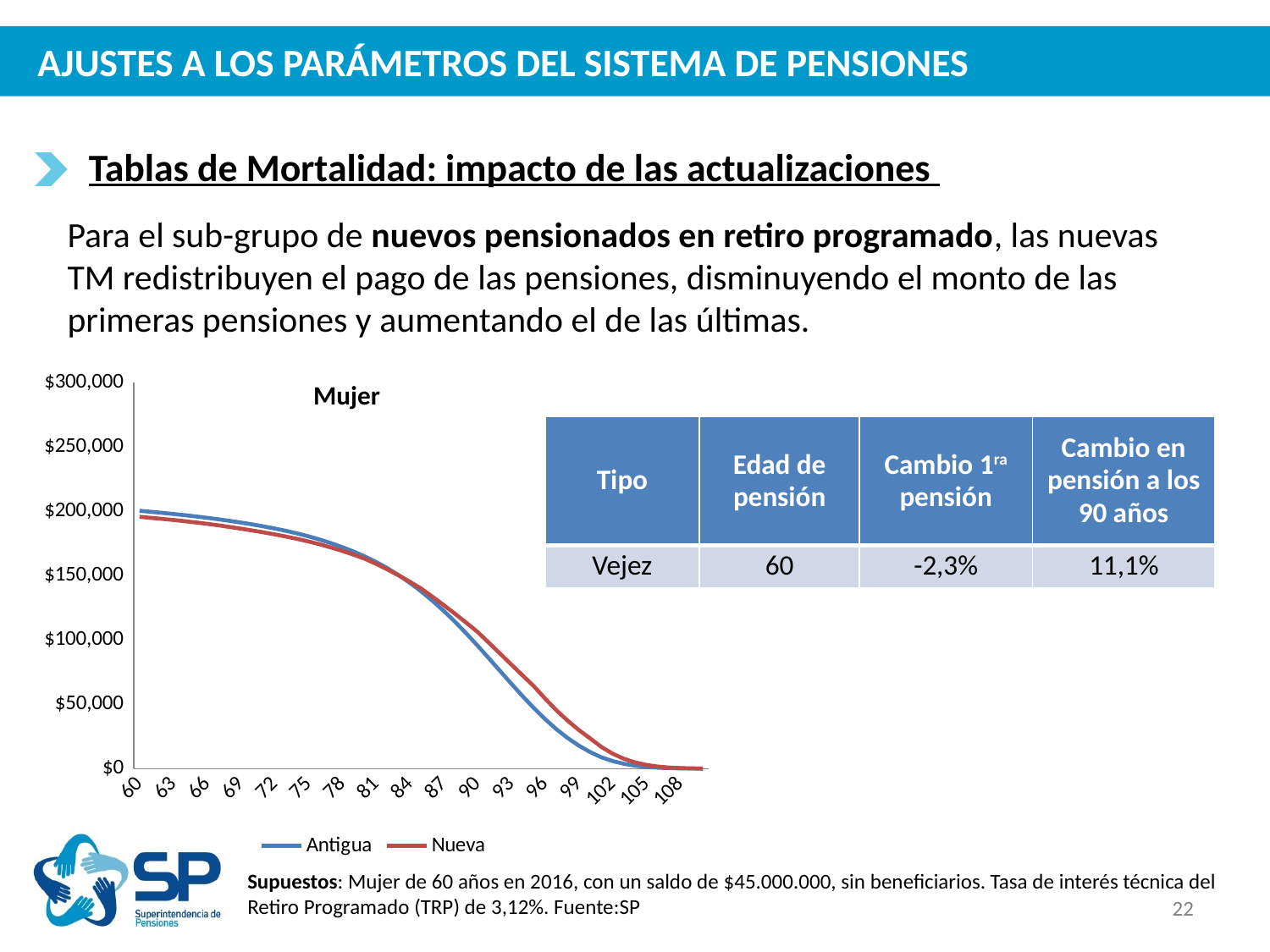
At age 60, which series has the higher value, Antigua or Nueva? Antigua What are the names of the two series in the chart's legend? Antigua and Nueva Is the value of the Antigua series at age 60 greater or less than $150,000? greater Is the value of the Nueva series at age 60 greater or less than $250,000? less Is the value of the Nueva series at age 99 greater or less than $50,000? less How many series does the chart's legend list? 2 At age 96, which series has the higher value, Antigua or Nueva? Nueva How many age labels are shown on the x axis of the chart? 17 What is the title of the chart? Mujer Do the values of the Antigua series rise or fall as age increases along the x axis? fall What kind of chart is shown on the slide? line chart